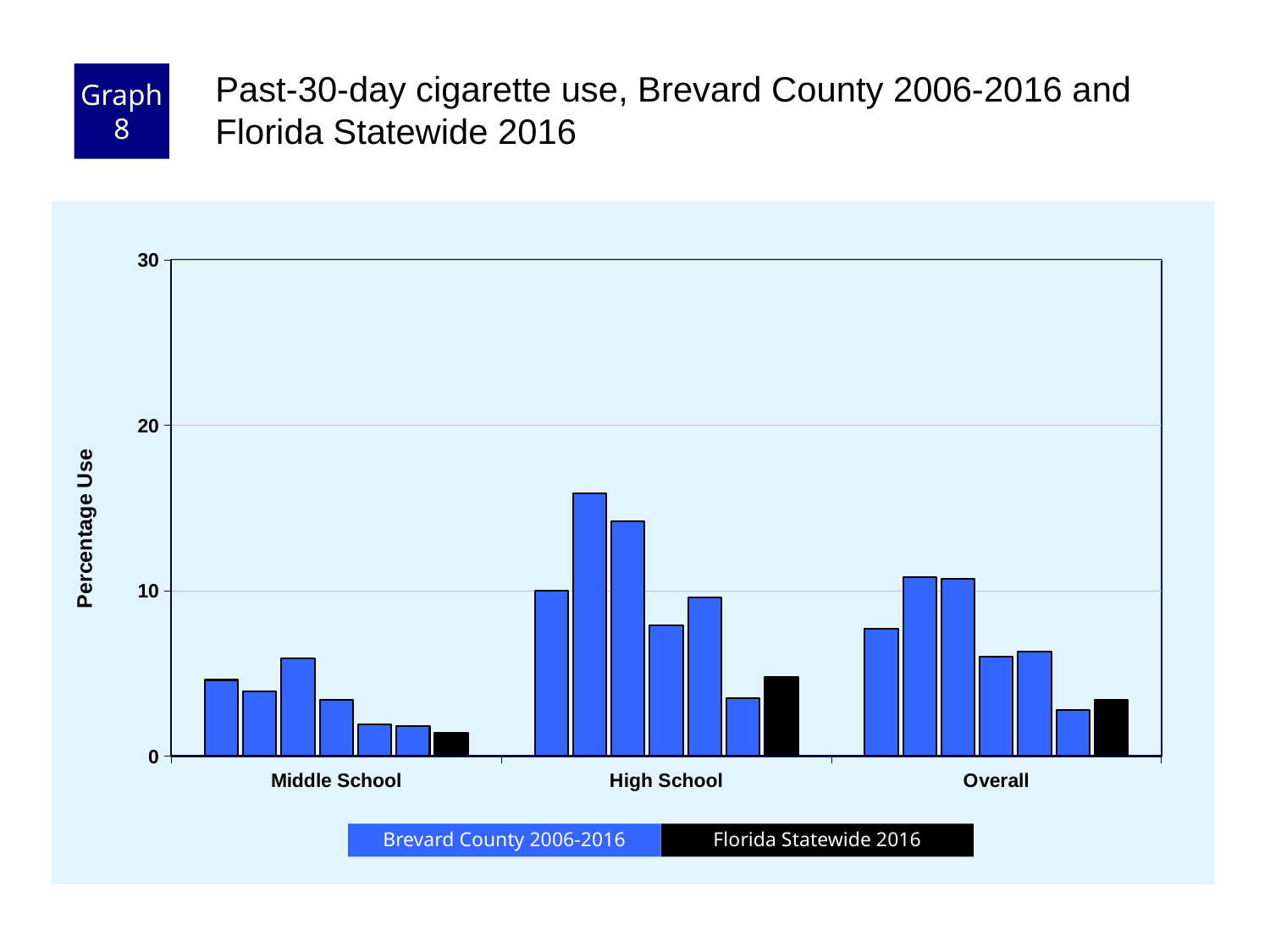
How many series does the legend list? 2 What is the label of the y axis? Percentage Use How many categories are shown on the x axis? 3 What kind of chart is shown on the slide? bar chart Is the tallest Brevard County 2006-2016 bar for High School greater or less than 10? greater Which category contains the tallest bar in the chart? High School Is the tallest Brevard County 2006-2016 bar for High School greater or less than 20? less Which series is shown in black in the legend? Florida Statewide 2016 Which category has the lowest Florida Statewide 2016 value? Middle School Which is larger, the Florida Statewide 2016 value for High School or for Overall? High School Is the Florida Statewide 2016 value for High School greater or less than 10? less Which category has the highest Florida Statewide 2016 value? High School